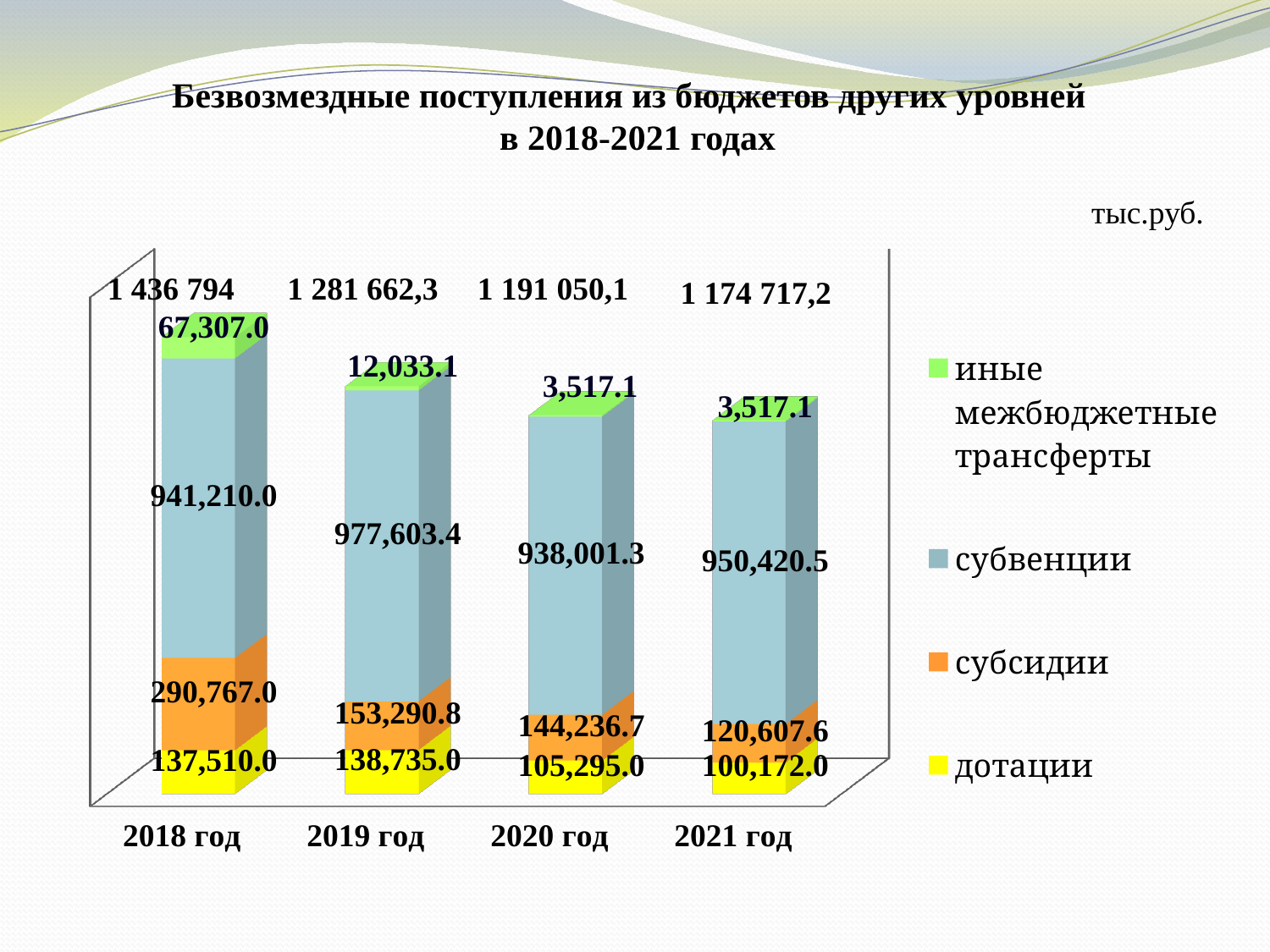
What is the value of дотации for 2020 год? 105,295.0 How many years are shown on the x axis? 4 Which year has the larger value of субсидии, 2019 год or 2020 год? 2019 год What is the difference between субвенции in 2021 год and 2020 год? 12,419.2 What kind of chart is shown on the slide? Stacked bar chart What is the value of субвенции for 2019 год? 977,603.4 What is the value of иные межбюджетные трансферты for 2021 год? 3,517.1 How many series does the legend list? 4 Do the values of иные межбюджетные трансферты rise or fall from 2018 год to 2021 год? Fall In which year is the value of субсидии the highest? 2018 год What is the total of the stacked bar for 2018 год? 1 436 794 In which year is the value of дотации the lowest? 2021 год